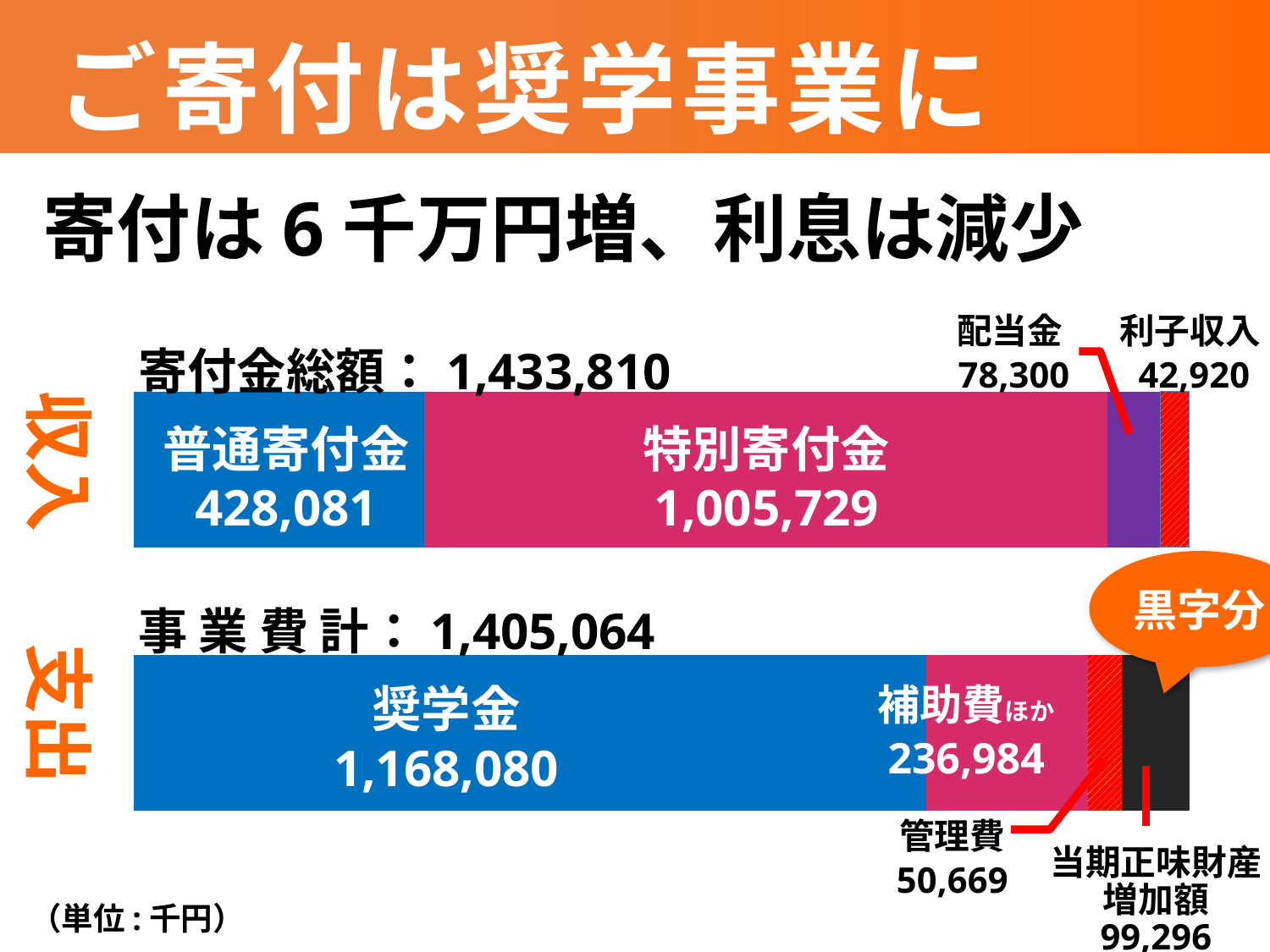
In the 収入 bar, what is the value for 利子収入? 42,920 In the 収入 bar, which segment is the largest? 特別寄付金 In the 収入 bar, what is the value for 配当金? 78,300 In the 支出 bar, what is the difference between 奨学金 and 補助費ほか? 931,096 In the 支出 bar, what is the value for 当期正味財産増加額? 99,296 In the 支出 bar, what is the value for 管理費? 50,669 What is the 寄付金総額 shown above the 収入 bar? 1,433,810 In the 収入 bar, what is the value for 普通寄付金? 428,081 In the 支出 bar, what is the value for 奨学金? 1,168,080 In the 収入 bar, what is the difference between 特別寄付金 and 普通寄付金? 577,648 In the 収入 bar, what is the value for 特別寄付金? 1,005,729 In the 収入 bar, which segment is the smallest? 利子収入